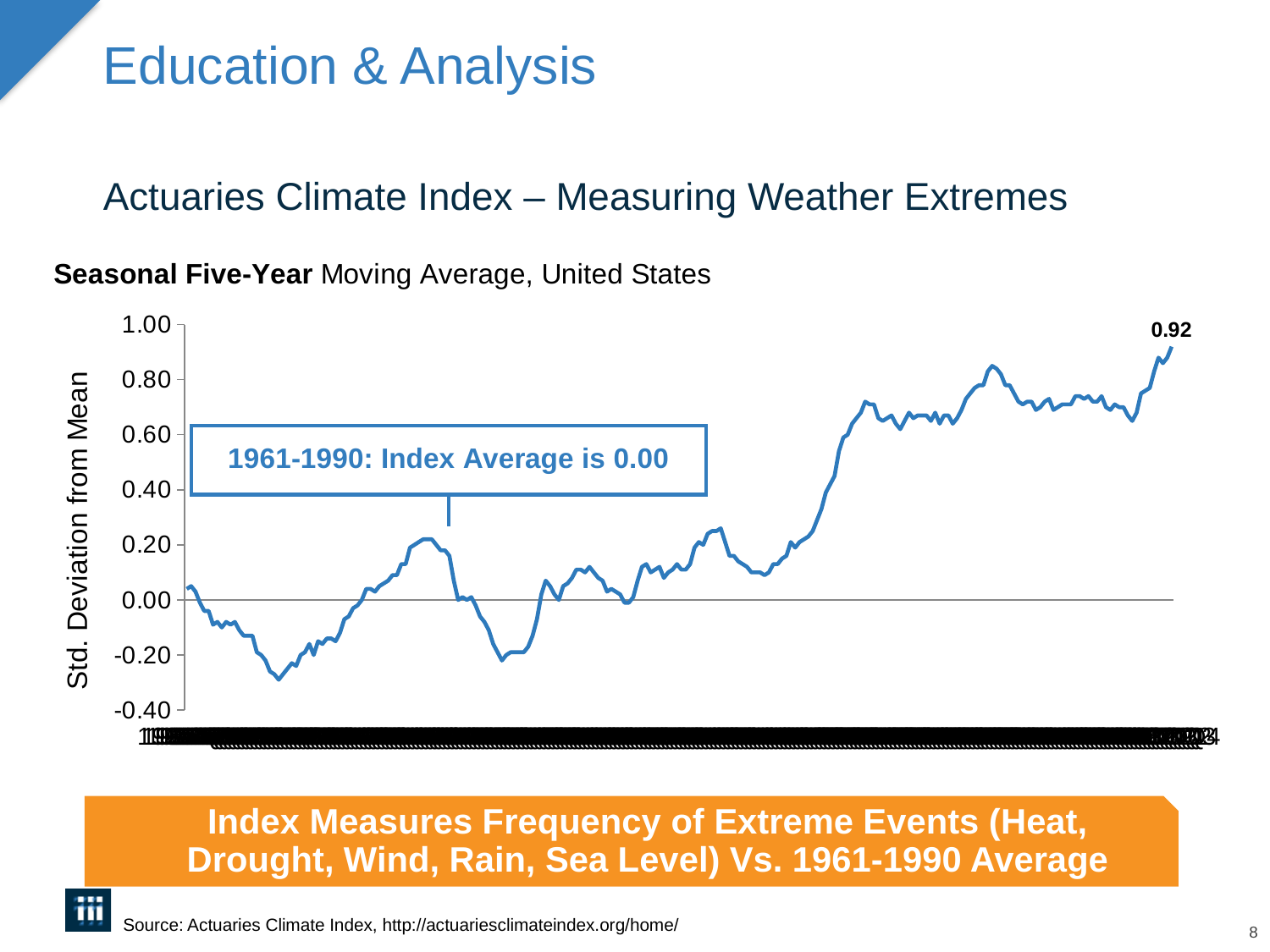
What is the highest tick value shown on the vertical axis? 1.00 What kind of chart is shown on the slide? Line chart Is the final value of the line greater or less than 0.80? greater How many data series are plotted in the chart? 1 According to the annotation box in the chart, what is the index average for 1961-1990? 0.00 Overall, does the line rise or fall from left to right across the chart? Rise Is the value at the right end of the line greater or less than the value at the left end of the line? greater What is the label on the vertical axis of the chart? Std. Deviation from Mean Is the lowest point of the line greater or less than -0.20? less What is the value printed at the end of the line in the chart? 0.92